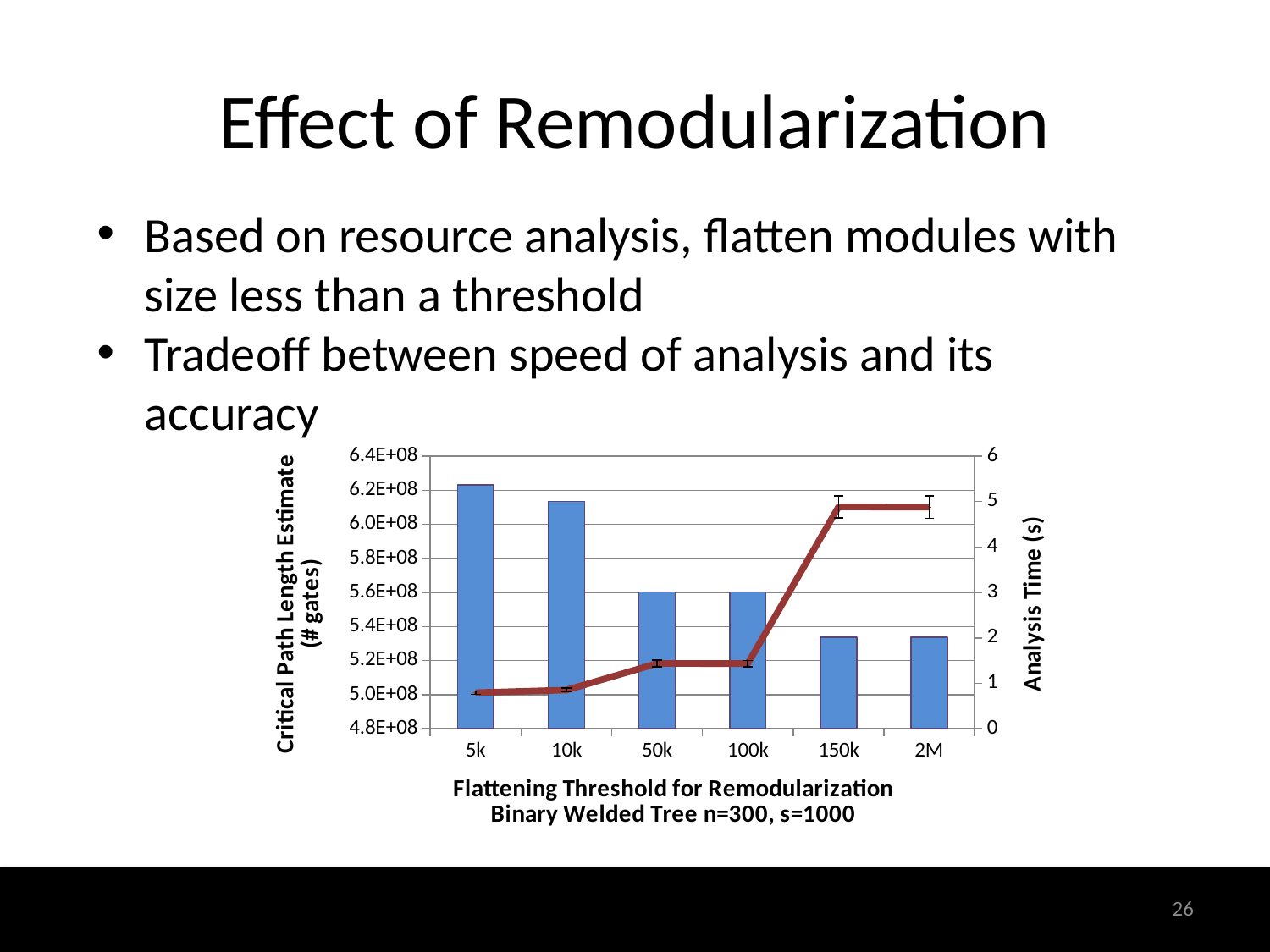
Which flattening threshold has the highest Critical Path Length Estimate bar? 5k Which has the larger Critical Path Length Estimate bar, 5k or 10k? 5k Is the Analysis Time for 150k greater or less than 4 seconds? greater What is the title of the right-hand vertical axis? Analysis Time (s) Does the Analysis Time line generally rise or fall as the flattening threshold increases? rise Is the Analysis Time for 5k greater or less than 1 second? less Is the Critical Path Length Estimate bar for 150k greater or less than 5.4E+08? less How many flattening threshold categories are shown on the x axis? 6 What kind of chart is shown on the slide? A combined bar and line chart Which has the higher Analysis Time, 100k or 150k? 150k Do the Critical Path Length Estimate bars generally rise or fall as the flattening threshold increases? fall